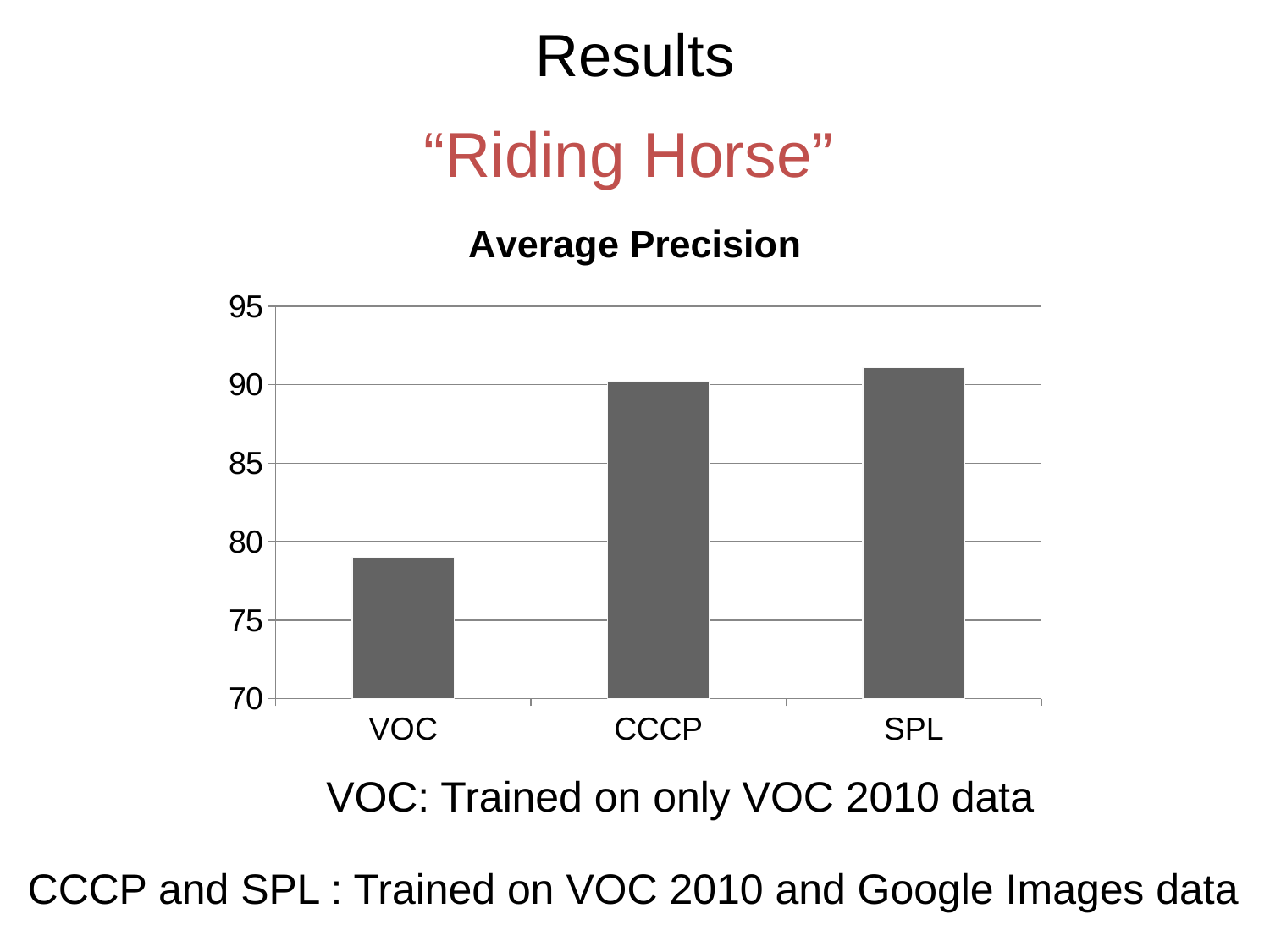
Which category has the lowest average precision? VOC What kind of chart is shown on the slide? bar chart What is the title of the chart? Average Precision Do the values rise or fall from left to right along the x axis? rise Is the value for CCCP greater or less than 85? greater What is the lowest value shown on the y axis of the chart? 70 Is the value for SPL greater or less than 85? greater Which is larger, the value for VOC or the value for CCCP? CCCP Which is larger, the value for VOC or the value for SPL? SPL Is the value for VOC greater or less than 80? less How many categories are shown on the x axis of the chart? 3